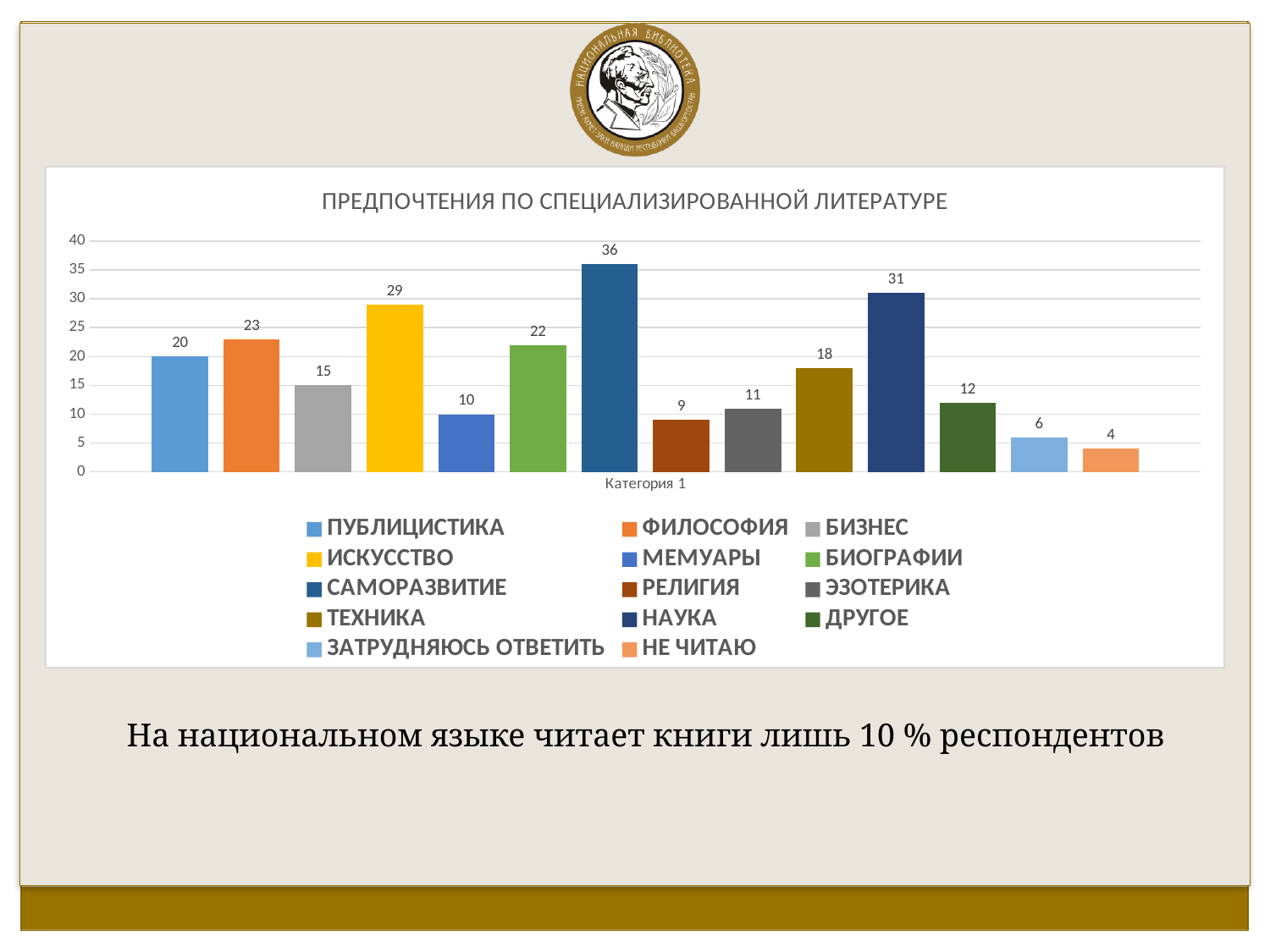
What is the value for РЕЛИГИЯ? 9 What kind of chart is shown on the slide? bar chart Which is larger, the value for ФИЛОСОФИЯ or the value for БИОГРАФИИ? ФИЛОСОФИЯ What is the title of the chart? ПРЕДПОЧТЕНИЯ ПО СПЕЦИАЛИЗИРОВАННОЙ ЛИТЕРАТУРЕ Which series has the lowest value? НЕ ЧИТАЮ What is the difference between the values for САМОРАЗВИТИЕ and НАУКА? 5 Is the value for ТЕХНИКА greater or less than 20? less What is the value for ИСКУССТВО? 29 Which series has the highest value? САМОРАЗВИТИЕ What is the value for ЗАТРУДНЯЮСЬ ОТВЕТИТЬ? 6 What is the value for САМОРАЗВИТИЕ? 36 How many series does the legend list? 14